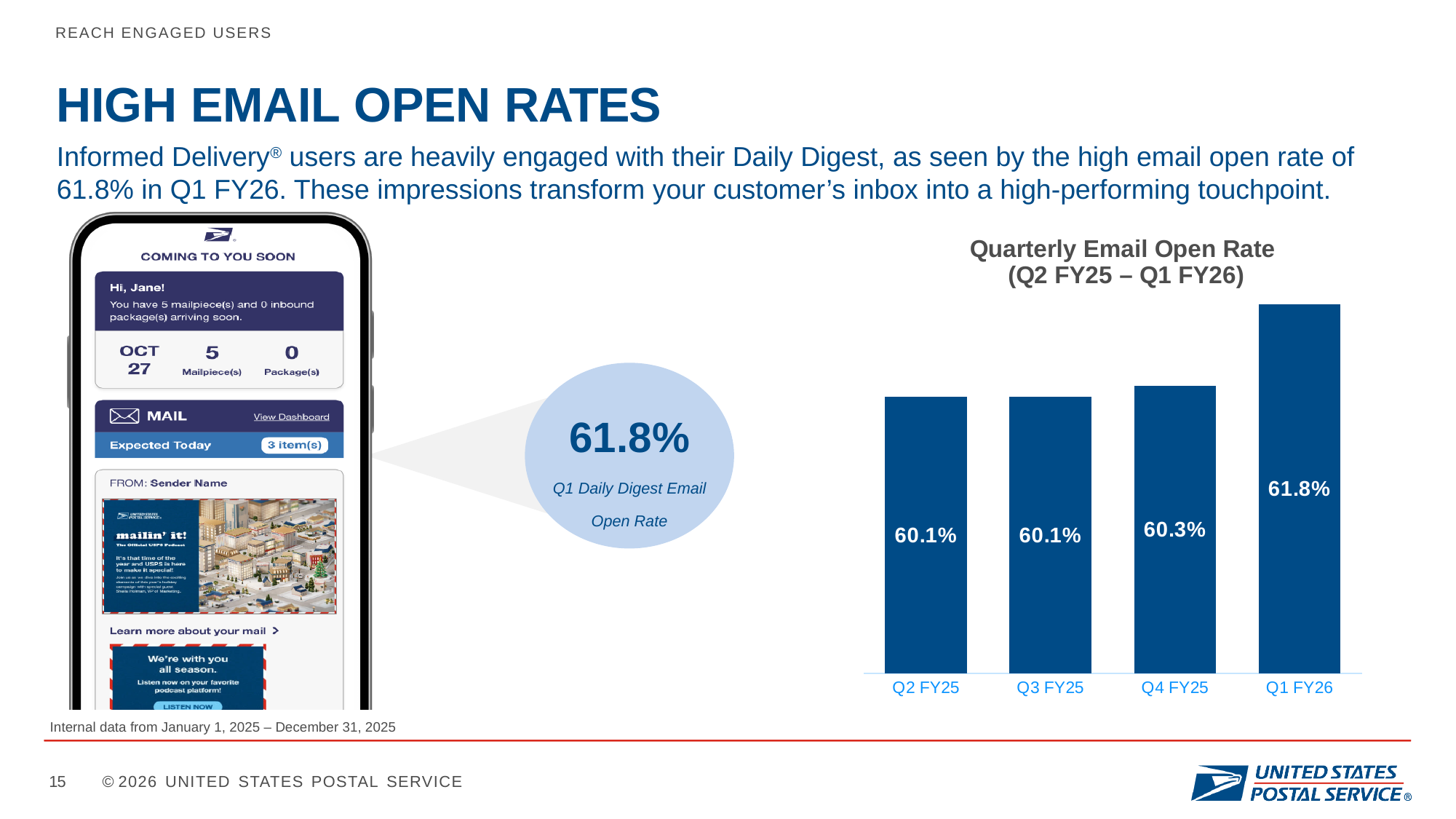
What is the difference in email open rate between Q1 FY26 and Q4 FY25? 1.5% How many quarters are shown in the chart? 4 Which quarter has the highest email open rate? Q1 FY26 What is the title of the chart? Quarterly Email Open Rate (Q2 FY25 – Q1 FY26) What is the difference in email open rate between Q4 FY25 and Q2 FY25? 0.2% What is the email open rate for Q1 FY26? 61.8% Which has a higher email open rate, Q1 FY26 or Q3 FY25? Q1 FY26 Do the email open rates rise or fall from Q2 FY25 to Q1 FY26? Rise What is the email open rate for Q4 FY25? 60.3% What is the email open rate for Q2 FY25? 60.1% What is the email open rate for Q3 FY25? 60.1% What kind of chart is used to show the quarterly email open rate? Bar chart